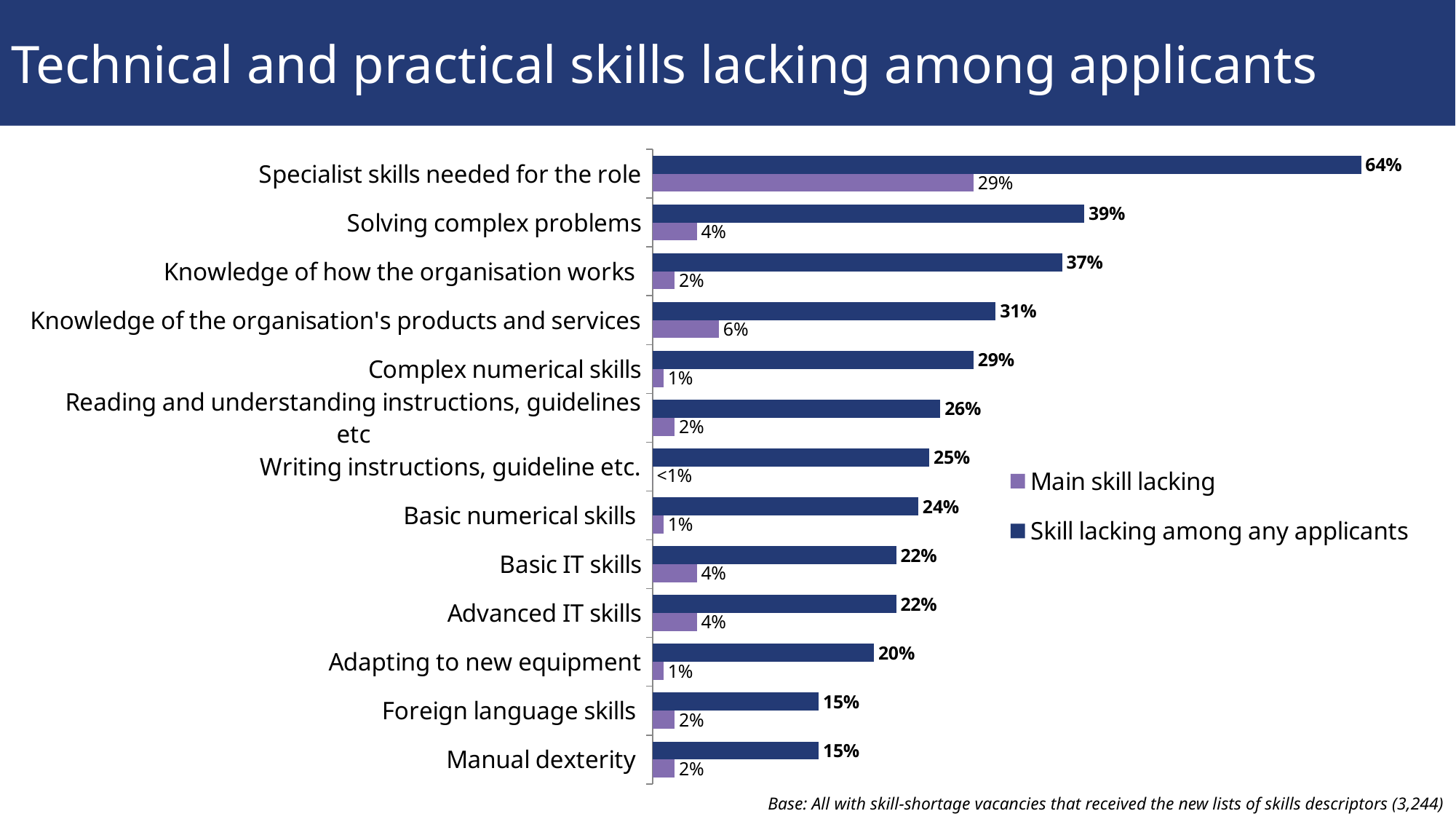
What is the difference between the 'Skill lacking among any applicants' values for Solving complex problems and Knowledge of how the organisation works? 2% What kind of chart is shown on the slide? Bar chart What is the value for 'Main skill lacking' for Writing instructions, guideline etc.? <1% What is the value for 'Skill lacking among any applicants' for Specialist skills needed for the role? 64% What is the value for 'Skill lacking among any applicants' for Adapting to new equipment? 20% Which category has the highest value for 'Skill lacking among any applicants'? Specialist skills needed for the role What is the difference between the two series values for Specialist skills needed for the role? 35% How many categories are shown on the chart? 13 Which is larger for 'Main skill lacking': Basic IT skills or Complex numerical skills? Basic IT skills Which category has the highest value for 'Main skill lacking'? Specialist skills needed for the role What is the value for 'Main skill lacking' for Knowledge of the organisation's products and services? 6% How many series does the legend list? 2